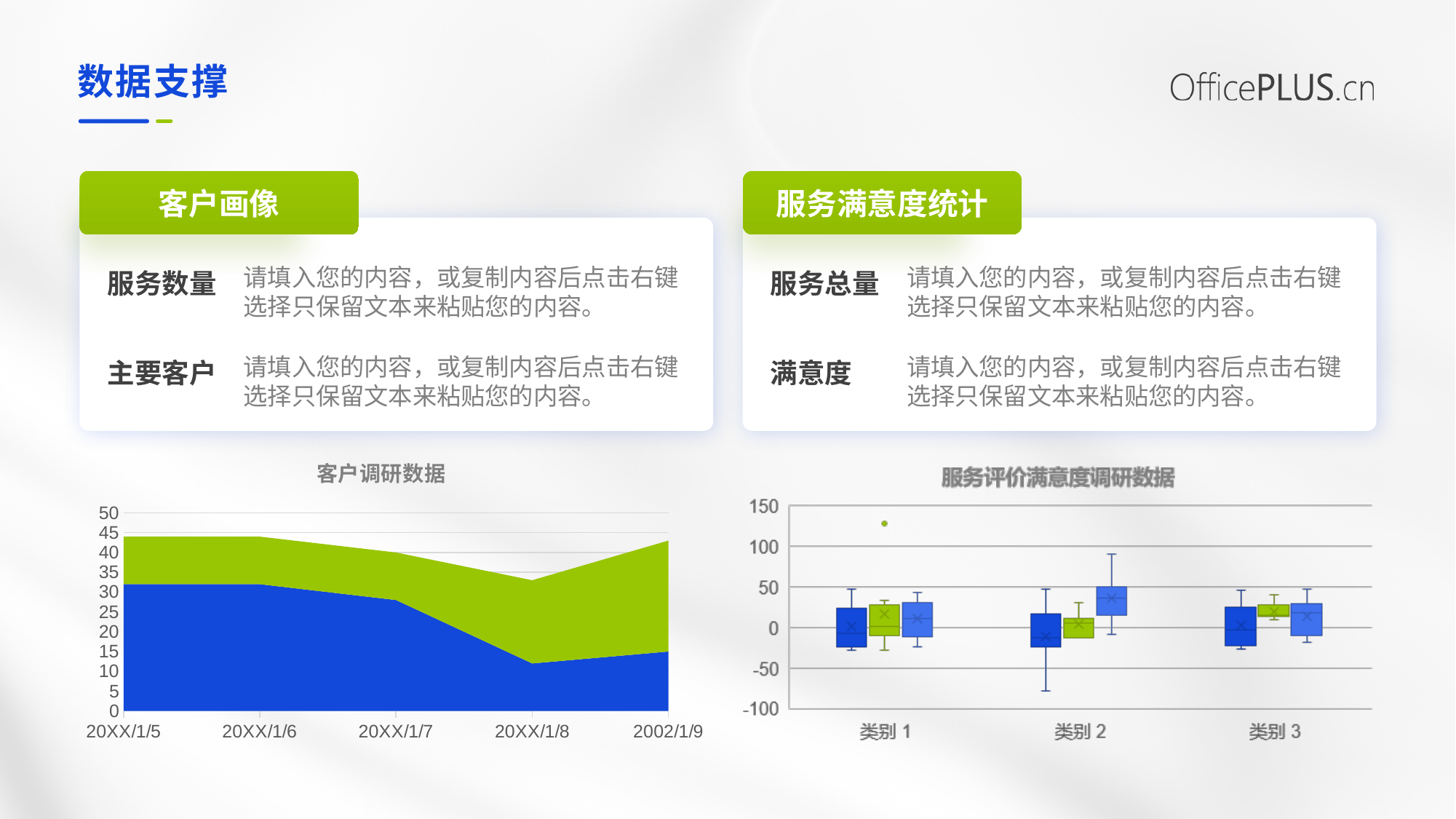
In the right chart 服务评价满意度调研数据, is the outlier point above 类别 1 greater or less than 100? greater In the left chart 客户调研数据, at which x-axis point is the blue series lowest? 20XX/1/8 In the left chart 客户调研数据, is the value of the blue series at 20XX/1/8 greater or less than 20? less In the right chart 服务评价满意度调研数据, how many categories are shown on the x axis? 3 In the left chart 客户调研数据, does the blue series rise or fall from 20XX/1/5 to 20XX/1/8? fall What kind of chart is the right chart titled 服务评价满意度调研数据? box-and-whisker chart In the left chart 客户调研数据, how many points are shown along the x axis? 5 In the left chart 客户调研数据, is the value of the blue series at 20XX/1/5 greater or less than 20? greater What is the title of the chart on the right side of the slide? 服务评价满意度调研数据 What kind of chart is the left chart titled 客户调研数据? area chart